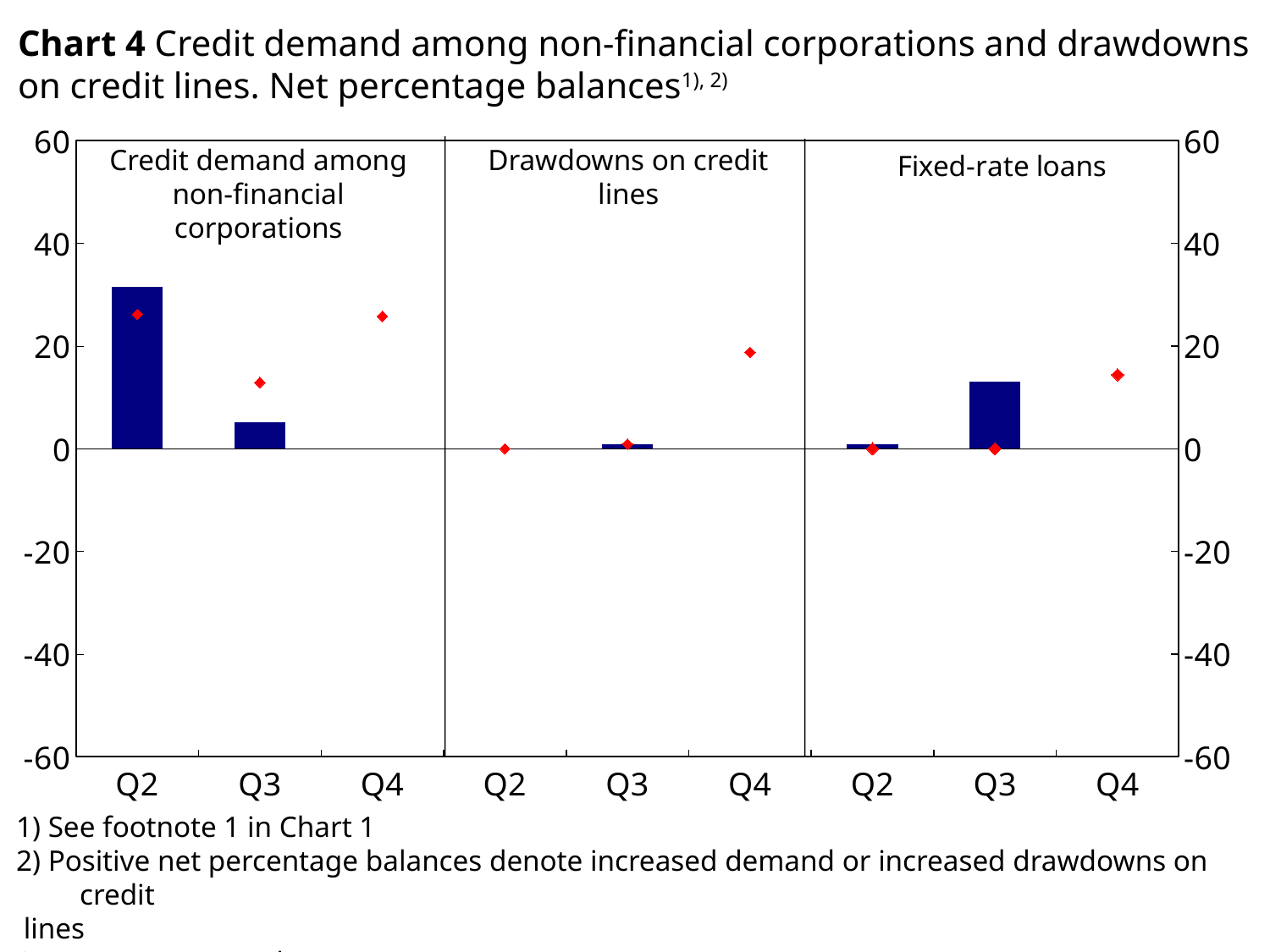
In the 'Credit demand among non-financial corporations' panel, which quarter has the tallest bar? Q2 How many panels does the chart have? 3 In the 'Credit demand among non-financial corporations' panel, do the bars rise or fall from Q2 to Q3? fall What kind of chart is shown on the slide? bar chart How many quarters are shown on the x axis of each panel? 3 In the 'Fixed-rate loans' panel, which quarter has the tallest bar? Q3 In the 'Fixed-rate loans' panel, is the Q3 bar greater or less than 20? less Which bar is taller: Q2 in the 'Credit demand among non-financial corporations' panel or Q3 in the 'Fixed-rate loans' panel? Q2 in the Credit demand among non-financial corporations panel In the 'Credit demand among non-financial corporations' panel, is the Q2 bar greater or less than 20? greater What is the title of the middle panel of the chart? Drawdowns on credit lines What are the minimum and maximum values shown on the y axis? -60 and 60 In the 'Credit demand among non-financial corporations' panel, is the Q3 bar greater or less than 20? less